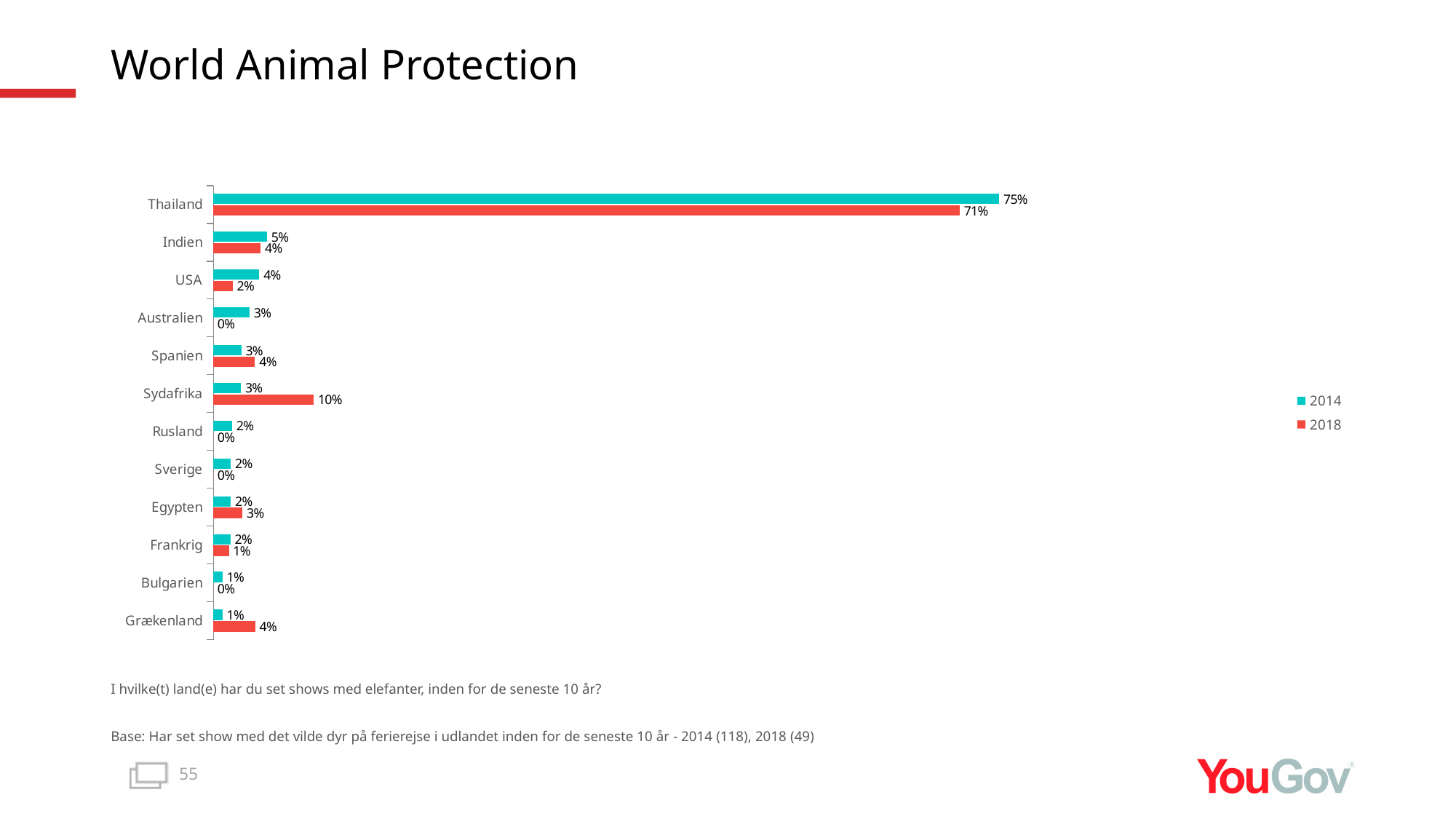
What is the difference between the 2014 and 2018 values for Thailand? 4 percentage points What is the 2018 value for Sydafrika? 10% What is the 2014 value for Thailand? 75% Which is larger for Spanien: the 2014 value or the 2018 value? 2018 What is the difference between the 2018 and 2014 values for Sydafrika? 7 percentage points Which country has the lowest 2014 value? Bulgarien and Grækenland (1%) How many countries are shown on the chart? 12 How many series does the legend list? 2 What is the 2018 value for Grækenland? 4% Which is larger for USA: the 2014 value or the 2018 value? 2014 Which country has the highest 2018 value? Thailand What kind of chart is shown on the slide? Bar chart